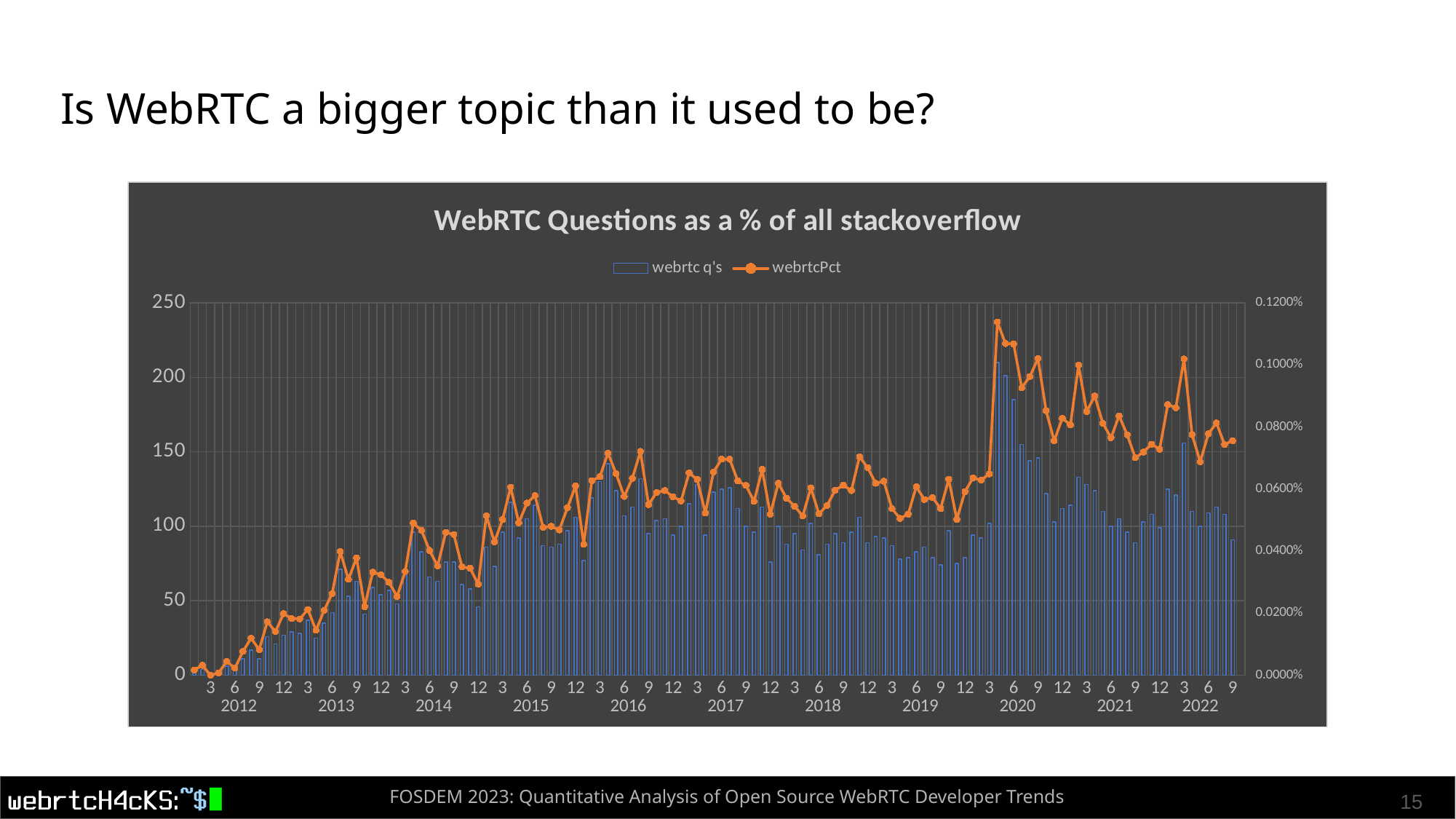
How many series does the chart legend list? 2 In which year are the webrtc q's bars at their lowest? 2012 In which year does the webrtcPct line reach its highest peak? 2020 Are the webrtc q's bars in 2012 greater or less than 50? less Overall, do the webrtc q's bars rise or fall from 2012 to 2020? Rise In which year do the webrtc q's bars reach their highest value? 2020 What kind of chart is this? A combined bar and line chart What is the title of the chart? WebRTC Questions as a % of all stackoverflow What are the names of the two series in the legend? webrtc q's and webrtcPct Which series is drawn as bars, webrtc q's or webrtcPct? webrtc q's Is the highest webrtc q's bar in 2020 greater or less than 200? greater Is the peak webrtcPct value in 2020 greater or less than 0.1000%? greater